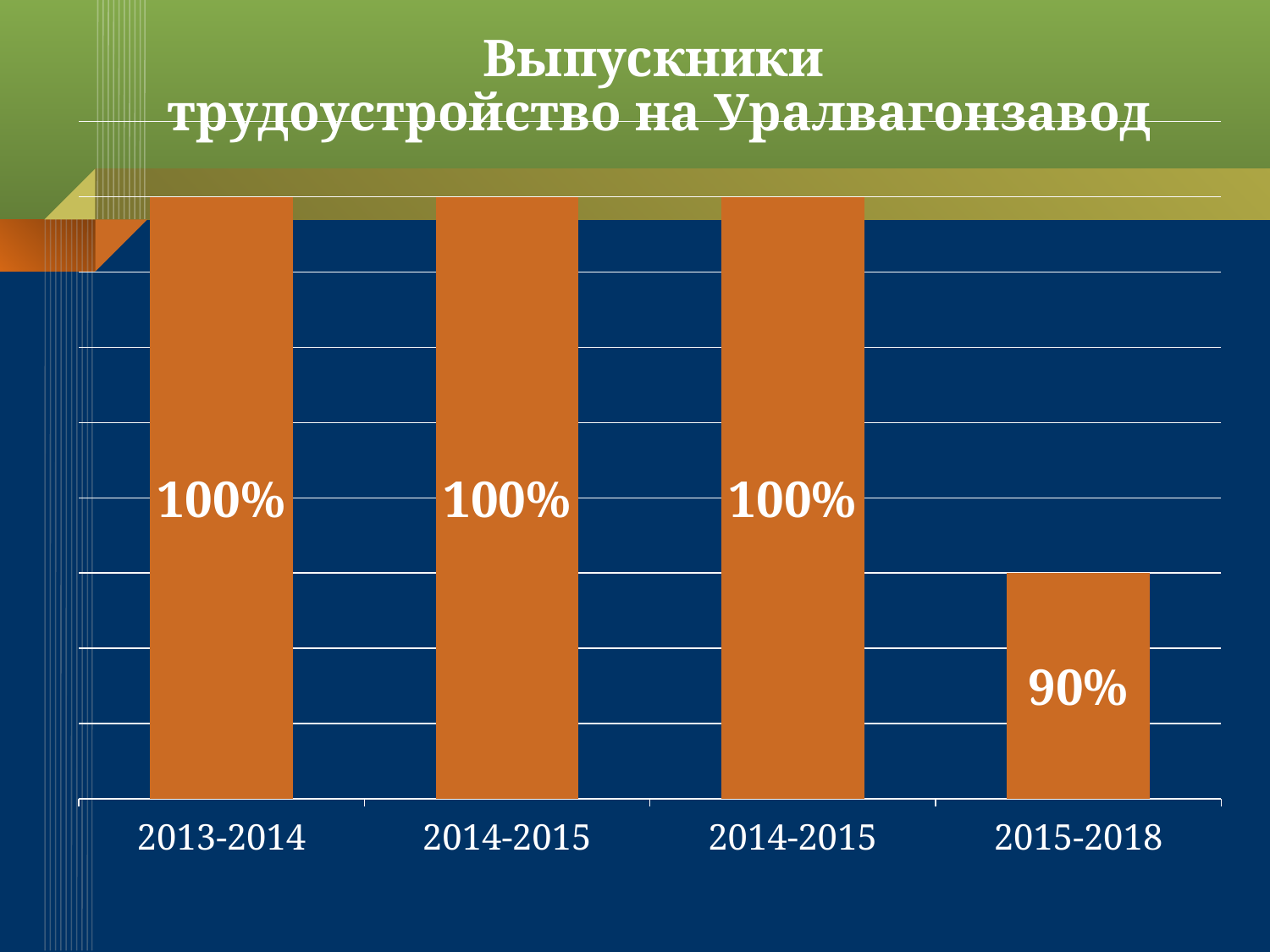
What is the value for 2015-2018? 90% Which category has the lowest value? 2015-2018 What is the title of the chart? Выпускники трудоустройство на Уралвагонзавод What kind of chart is shown on the slide? bar chart What is the difference between the values for 2013-2014 and 2015-2018? 10% Do the values rise or fall from the first category to the last along the x axis? fall What value is shown for the 2014-2015 bars? 100% How many bars show a value of 100%? 3 Which is larger, the value for 2013-2014 or the value for 2015-2018? 2013-2014 How many bars are shown in the chart? 4 What colour are the bars in the chart? orange What is the value for 2013-2014? 100%